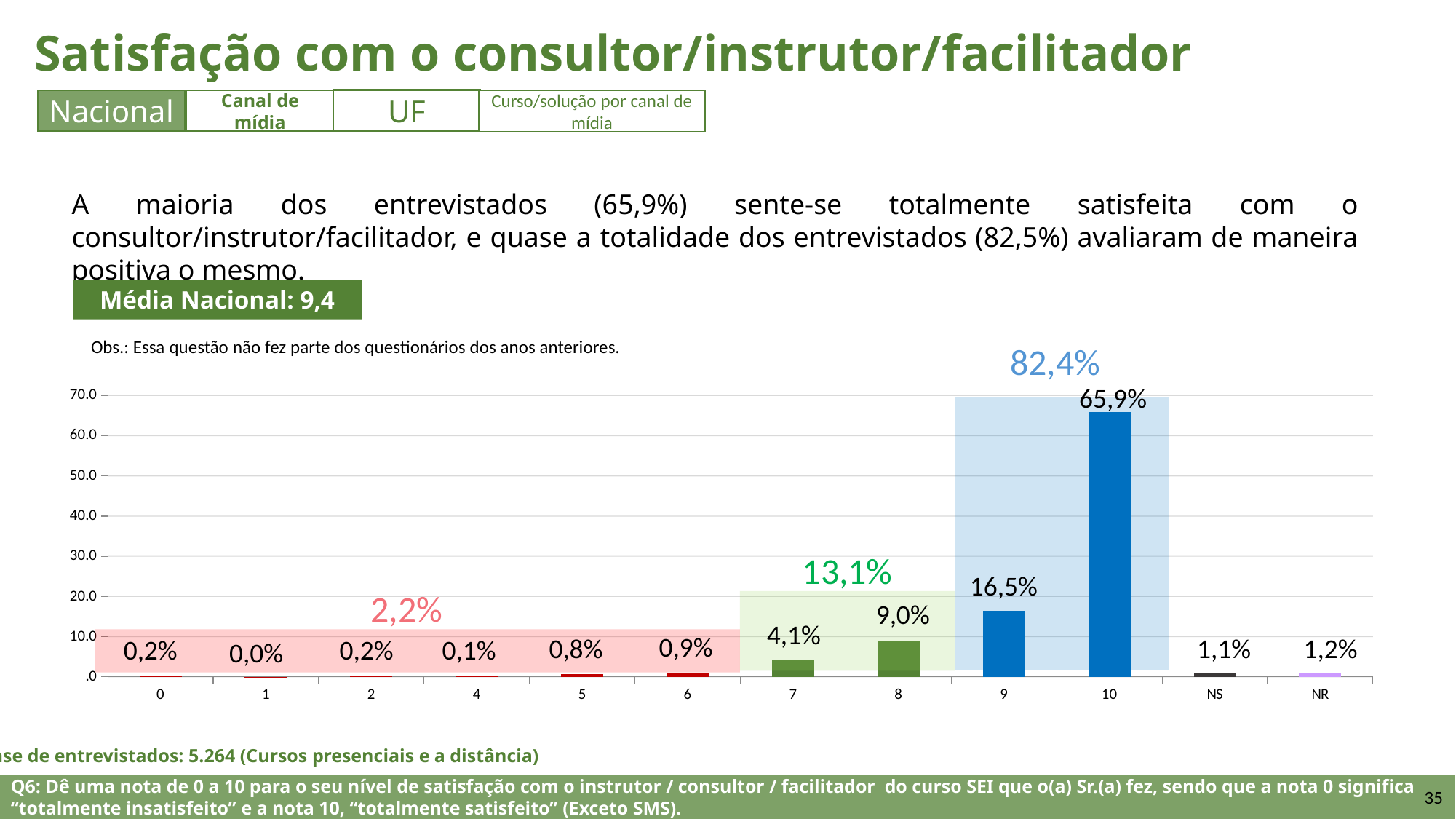
Is the value for score 10 greater or less than 60.0? greater What is the value for score 8? 9,0% What is the value for NR? 1,2% What percentage is shown above the blue shaded group covering scores 9 and 10? 82,4% Which is larger, the value for score 7 or the value for score 8? 8 How many categories are shown on the x axis? 12 What kind of chart is shown on the slide? bar chart What is the value for score 10? 65,9% What is the difference between the values for score 10 and score 9? 49,4% Which category has the lowest value? 1 Which category has the highest value? 10 What is the value for score 9? 16,5%